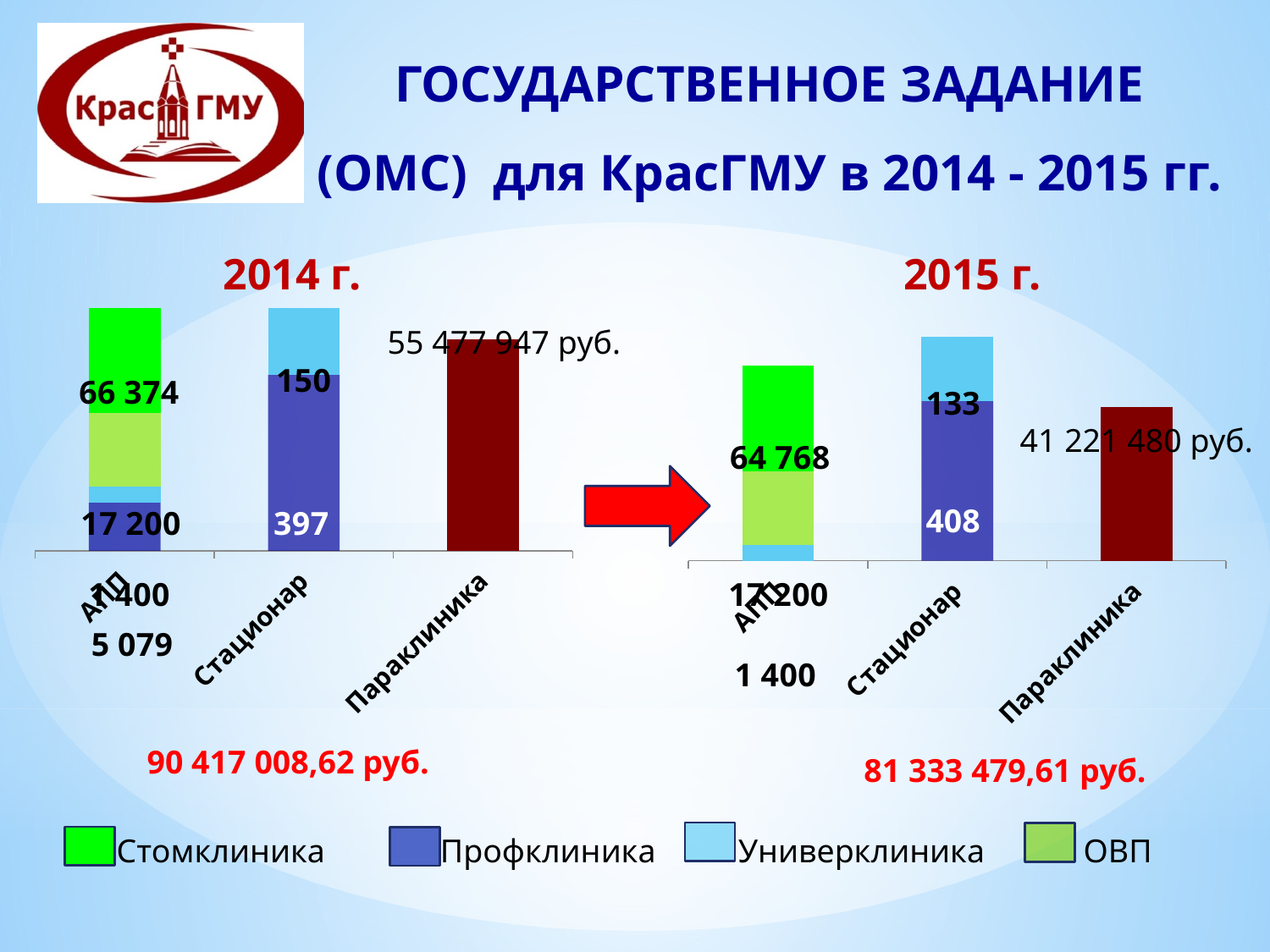
On the 2015 г. chart, what is the value of the Профклиника segment for Стационар? 408 On the 2014 г. chart, what value is labelled for Параклиника? 55 477 947 руб. What is the difference between the Профклиника values for Стационар in the 2015 г. chart (408) and the 2014 г. chart (397)? 11 What kind of chart is the 2015 г. chart? Stacked bar chart On the 2014 г. chart, what is the value of the Профклиника segment for Стационар? 397 How many categories are shown on the x axis of the 2014 г. chart? 3 On the 2015 г. chart, what is the value of the Универклиника segment for Стационар? 133 On the 2014 г. chart, what is the value of the Универклиника segment for Стационар? 150 Which is larger: the Профклиника value for Стационар in the 2014 г. chart or in the 2015 г. chart? 2015 г. What is the difference between the Универклиника values for Стационар in the 2014 г. chart (150) and the 2015 г. chart (133)? 17 How many series does the legend at the bottom of the slide list? 4 On the 2015 г. chart, what value is labelled for Параклиника? 41 221 480 руб.